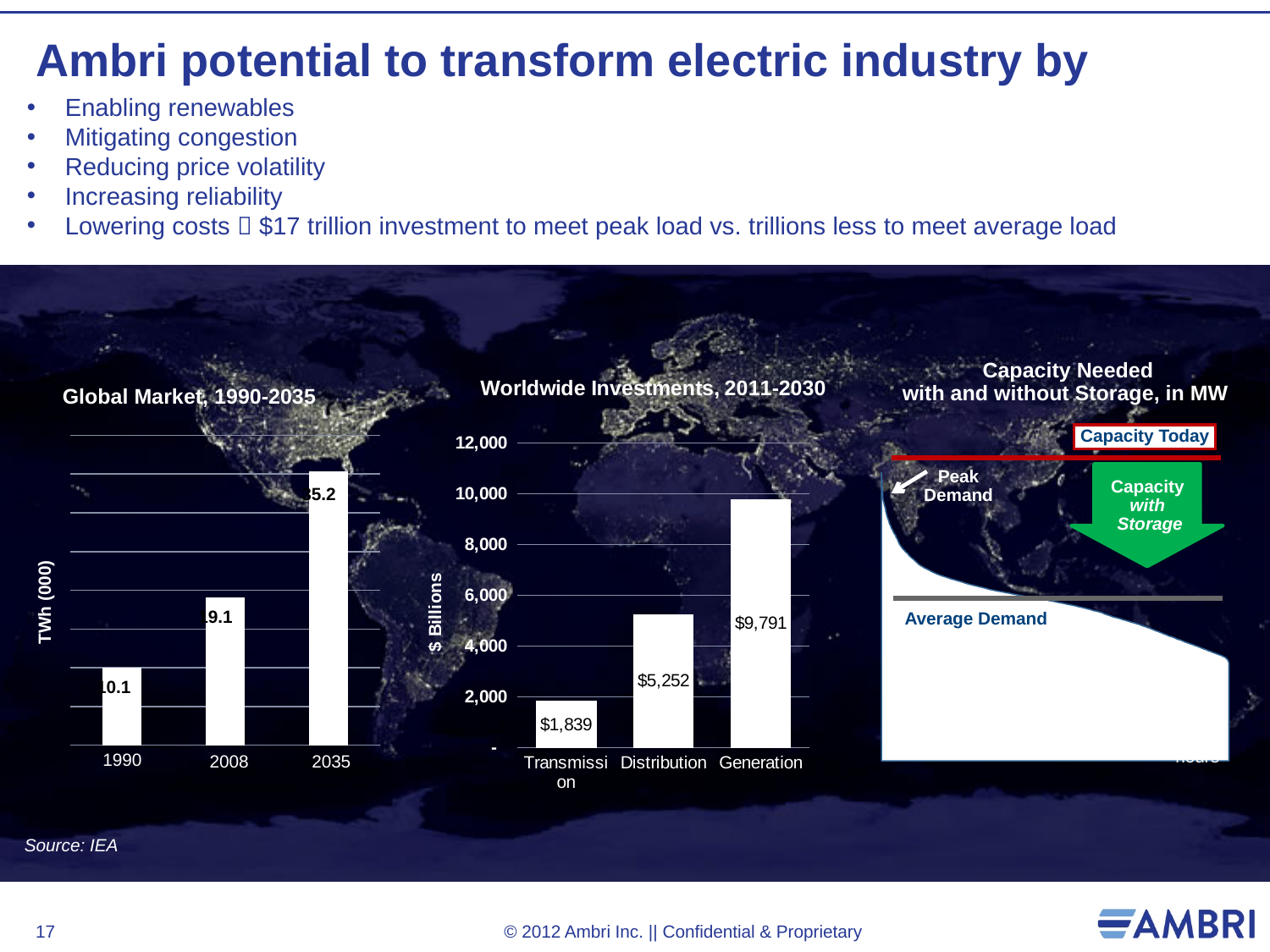
In the Worldwide Investments, 2011-2030 chart, what is the difference between Generation and Distribution? $4,539 In the Worldwide Investments, 2011-2030 chart, what is the value for Generation? $9,791 In the Worldwide Investments, 2011-2030 chart, which category has the highest value? Generation In the Worldwide Investments, 2011-2030 chart, what is the value for Distribution? $5,252 In the Worldwide Investments, 2011-2030 chart, what is the value for Transmission? $1,839 In the Global Market, 1990-2035 chart, which year has the highest value? 2035 In the Worldwide Investments, 2011-2030 chart, which category has the lowest value? Transmission In the Worldwide Investments, 2011-2030 chart, which is larger, Distribution or Transmission? Distribution In the Global Market, 1990-2035 chart, do the values rise or fall from 1990 to 2035? rise In the Worldwide Investments, 2011-2030 chart, what is the y-axis label? $ Billions In the Worldwide Investments, 2011-2030 chart, how many categories are shown? 3 What kind of chart is the Global Market, 1990-2035 chart? bar chart